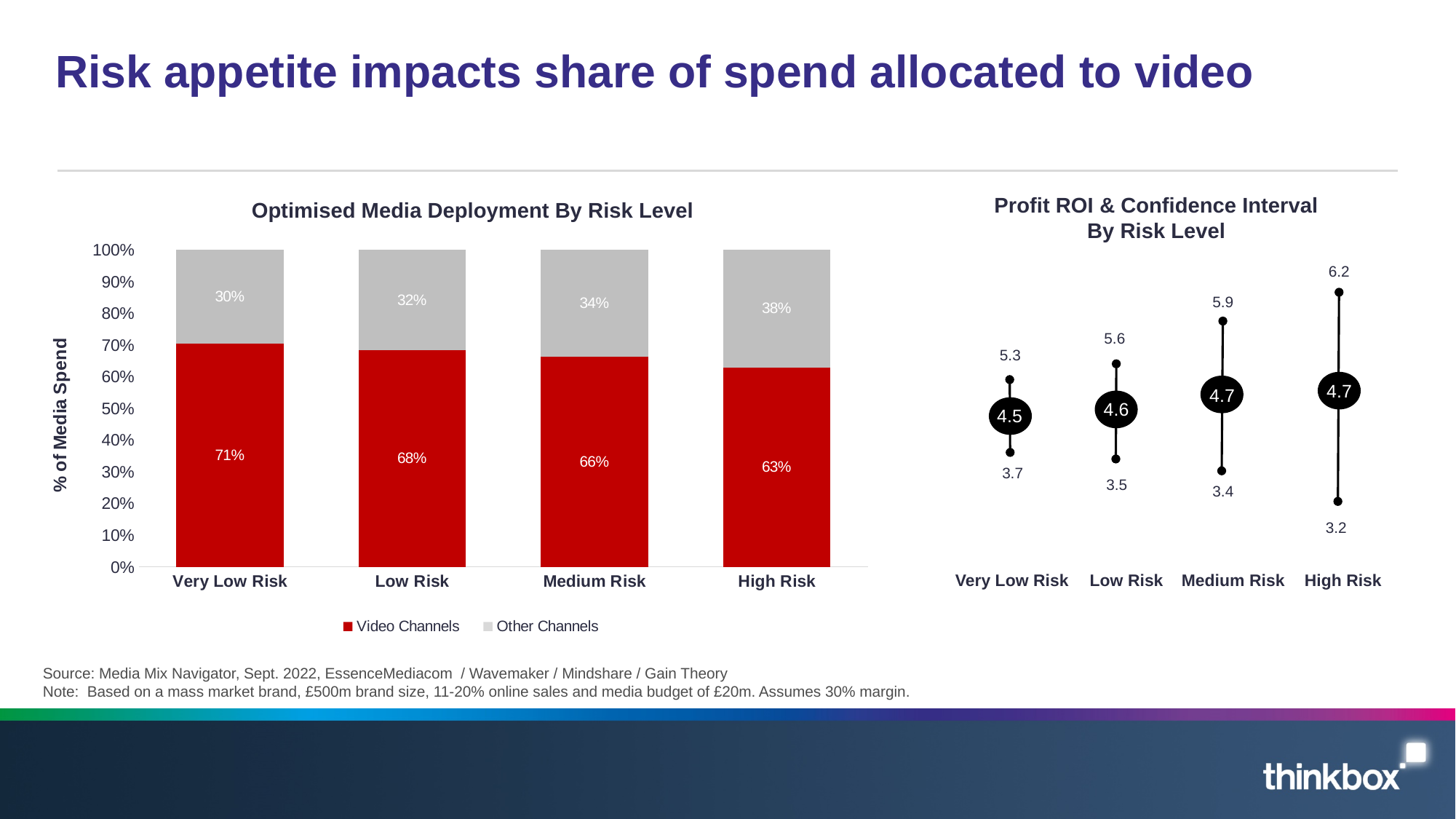
In the 'Optimised Media Deployment By Risk Level' chart, what is the difference between the Video Channels share for Very Low Risk and High Risk? 8% In the 'Profit ROI & Confidence Interval By Risk Level' chart, what is the lower confidence interval value for Medium Risk? 3.4 In the 'Profit ROI & Confidence Interval By Risk Level' chart, what is the upper confidence interval value for High Risk? 6.2 In the 'Optimised Media Deployment By Risk Level' chart, does the Video Channels share rise or fall as risk level increases from Very Low Risk to High Risk? fall In the 'Profit ROI & Confidence Interval By Risk Level' chart, what is the Profit ROI value for Low Risk? 4.6 In the 'Optimised Media Deployment By Risk Level' chart, what is the Video Channels value for Very Low Risk? 71% In the 'Optimised Media Deployment By Risk Level' chart, which risk level has the lowest Video Channels share? High Risk In the 'Profit ROI & Confidence Interval By Risk Level' chart, how many risk levels are shown? 4 In the 'Optimised Media Deployment By Risk Level' chart, what is the Other Channels value for High Risk? 38% In the 'Profit ROI & Confidence Interval By Risk Level' chart, which is larger: the upper confidence interval for Very Low Risk or for Low Risk? Low Risk In the 'Optimised Media Deployment By Risk Level' chart, how many series does the legend list? 2 What kind of chart is 'Optimised Media Deployment By Risk Level'? stacked bar chart